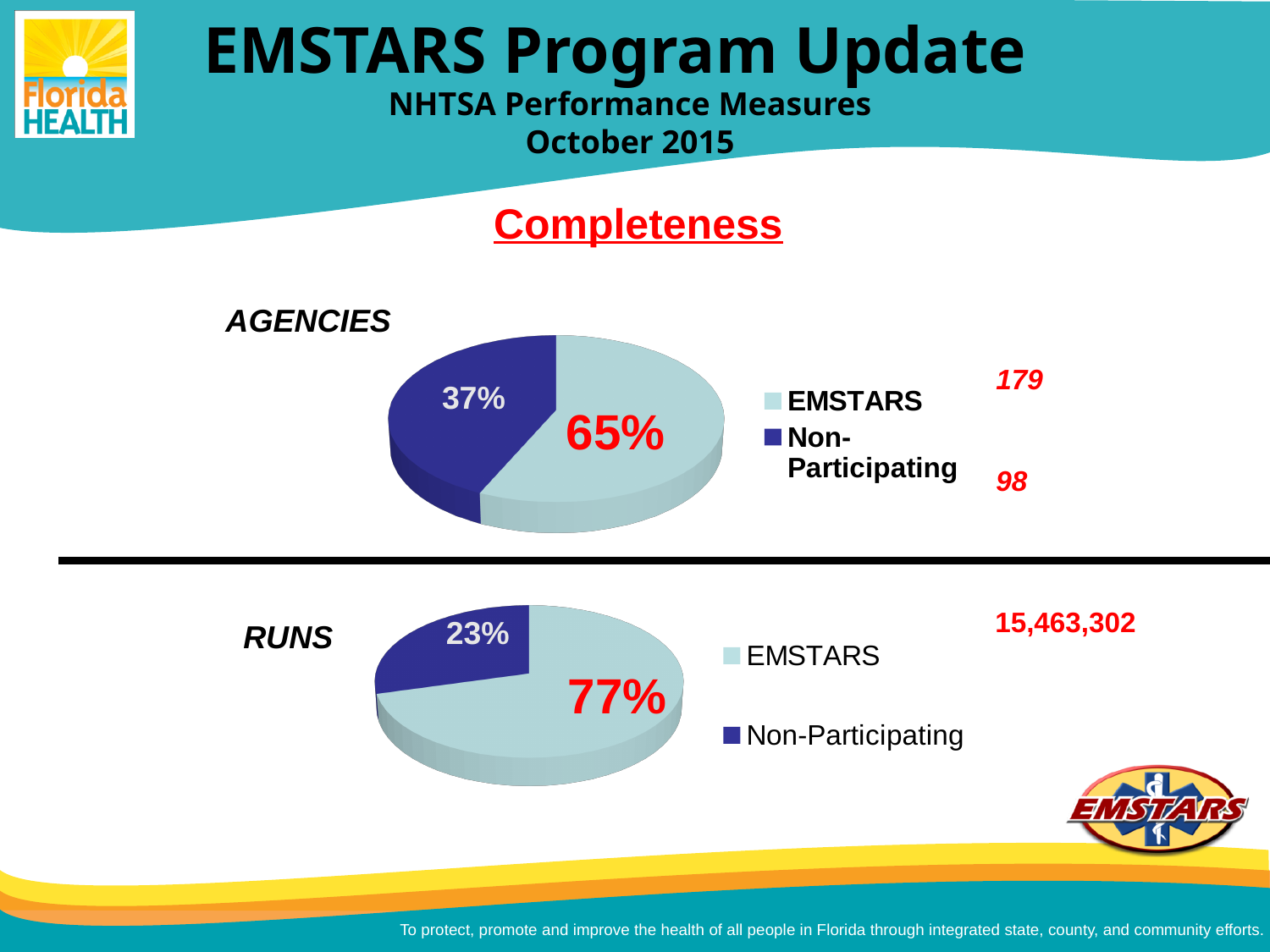
How many slices does the RUNS pie chart have? 2 In the RUNS chart, what share of the pie is EMSTARS? 77% In the AGENCIES chart, what share of the pie is EMSTARS? 65% In the AGENCIES chart, which slice is larger, EMSTARS or Non-Participating? EMSTARS What kind of chart is the RUNS chart? pie chart In the AGENCIES chart, what colour is the Non-Participating slice? dark blue In the RUNS chart, what is the difference between the EMSTARS share and the Non-Participating share? 54% In the AGENCIES chart, what share of the pie is Non-Participating? 37% In the RUNS chart, which slice is the smallest? Non-Participating In the RUNS chart, which slice is the largest? EMSTARS What kind of chart is the AGENCIES chart? pie chart